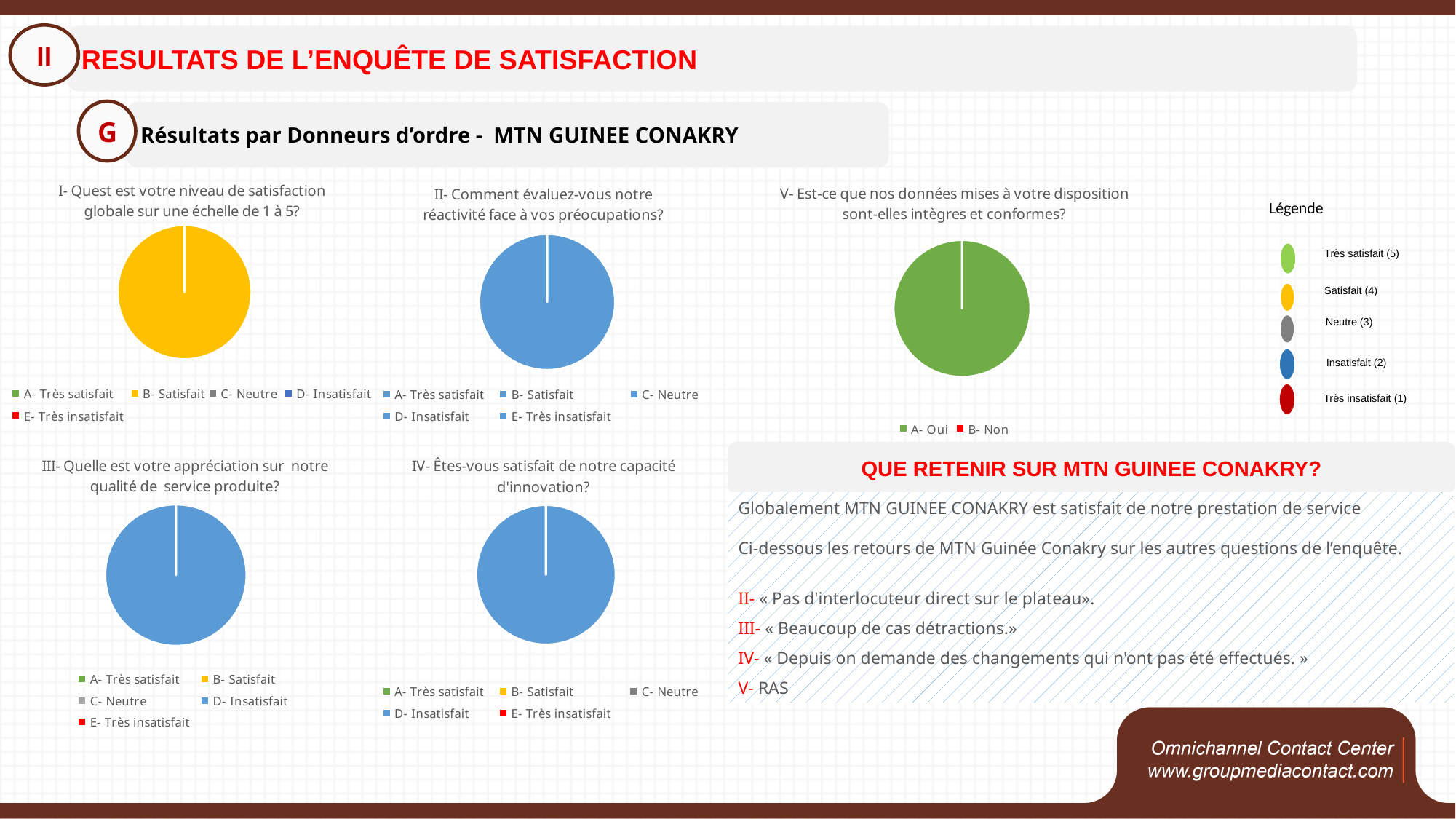
How many visible slices does the pie for question IV (capacité d'innovation) contain? 1 What kind of chart is used for question I (satisfaction globale sur une échelle de 1 à 5)? pie chart How many categories does the legend list for the chart on question I (satisfaction globale)? 5 In the chart for question III (qualité de service produite), which category accounts for the largest share of the pie? D- Insatisfait In the chart for question I (satisfaction globale), which category accounts for the largest share of the pie? B- Satisfait How many pie charts are shown on the slide? 5 In the chart for question IV (capacité d'innovation), which category accounts for the largest share of the pie? D- Insatisfait What colour is the pie for question V (données intègres et conformes)? green How many categories does the legend list for the chart on question III (qualité de service produite)? 5 How many categories does the legend list for the chart on question V (données intègres et conformes)? 2 What colour is the pie for question I (satisfaction globale)? yellow